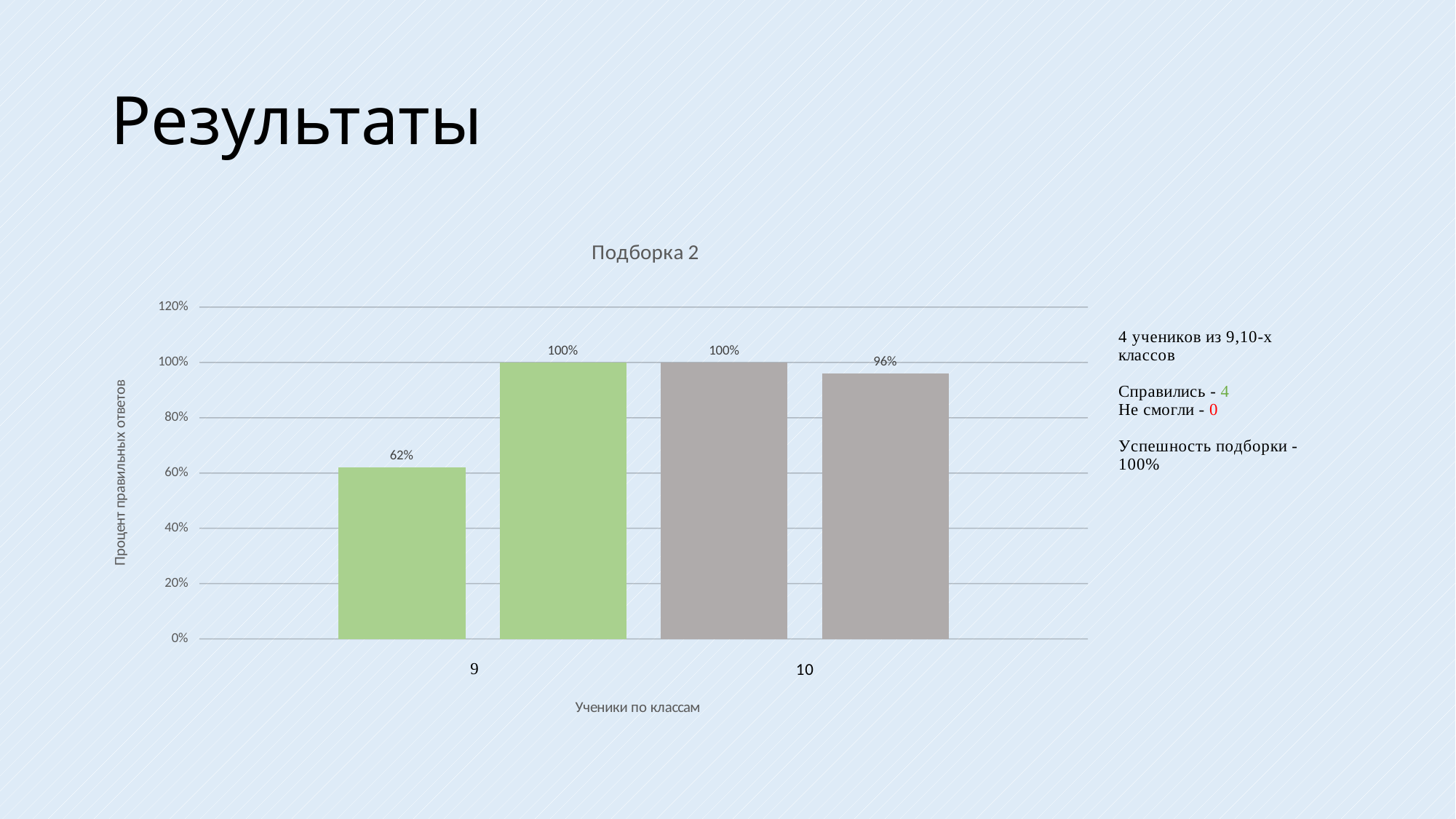
What is the label of the vertical axis of the chart? Процент правильных ответов What is the value of the first (left) bar for class 9? 62% What is the difference between the two bars for class 10? 4% What is the title of the chart? Подборка 2 Which bar has the lowest value in the chart? the first bar for class 9 (62%) How many class categories are shown on the x axis of the chart? 2 Which is larger: the first bar for class 9 or the second bar for class 10? the second bar for class 10 How many bars are plotted in the chart in total? 4 What kind of chart is shown on the slide? bar chart What is the difference between the two bars for class 9? 38% What is the value of the second (right) bar for class 9? 100% What is the value of the second (right) bar for class 10? 96%